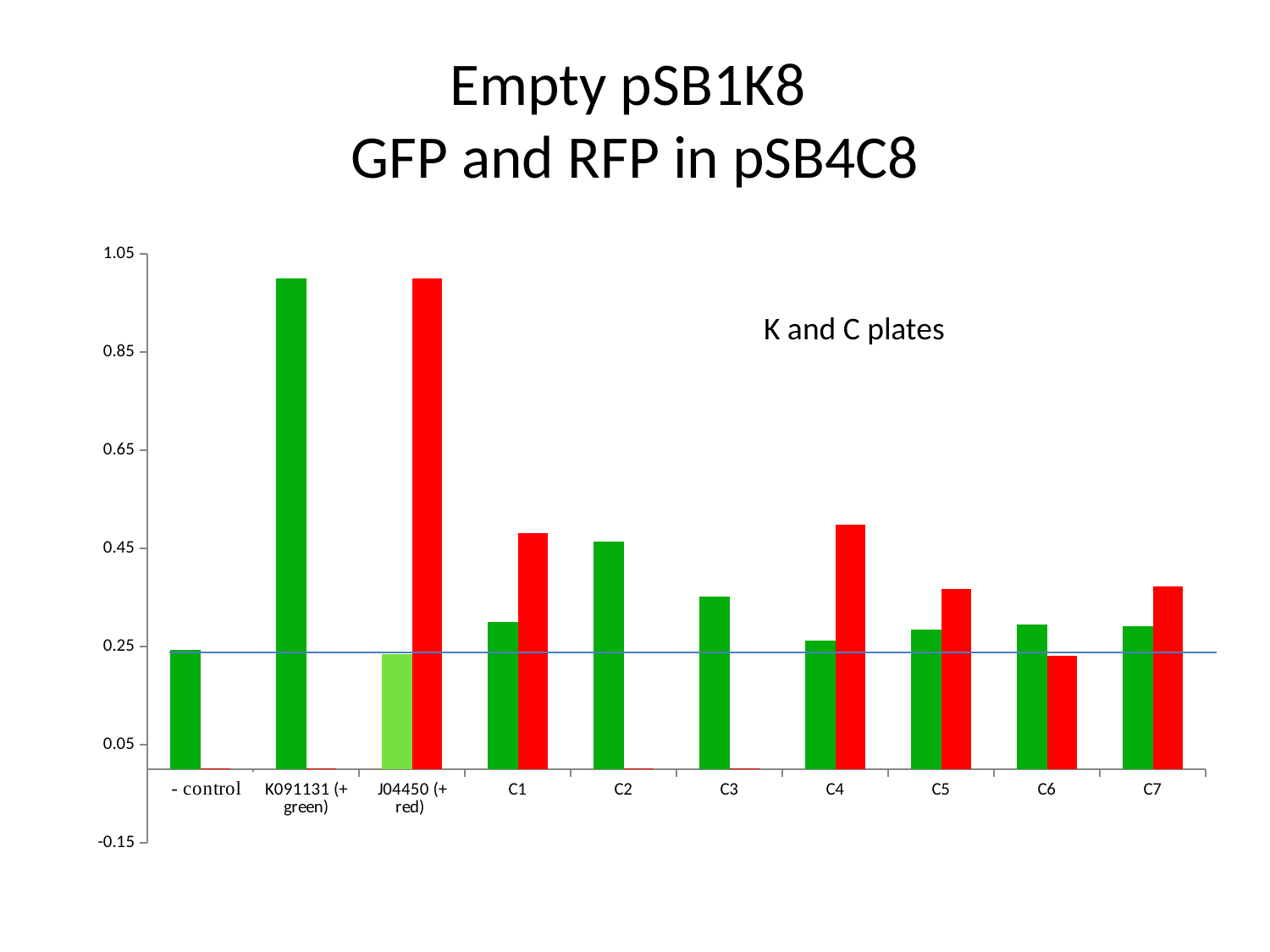
Is the red bar for J04450 (+ red) greater or less than 0.85? greater Is the red bar for C4 greater or less than 0.45? greater Is the green bar for C3 greater or less than 0.45? less For C4, which bar is taller, the green bar or the red bar? red bar What kind of chart is shown on the slide? bar chart How many categories are shown along the x axis of the chart? 10 Which category has the tallest green bar? K091131 (+ green) For C6, which bar is taller, the green bar or the red bar? green bar Which category has the tallest red bar? J04450 (+ red) What is the title of the slide? Empty pSB1K8 GFP and RFP in pSB4C8